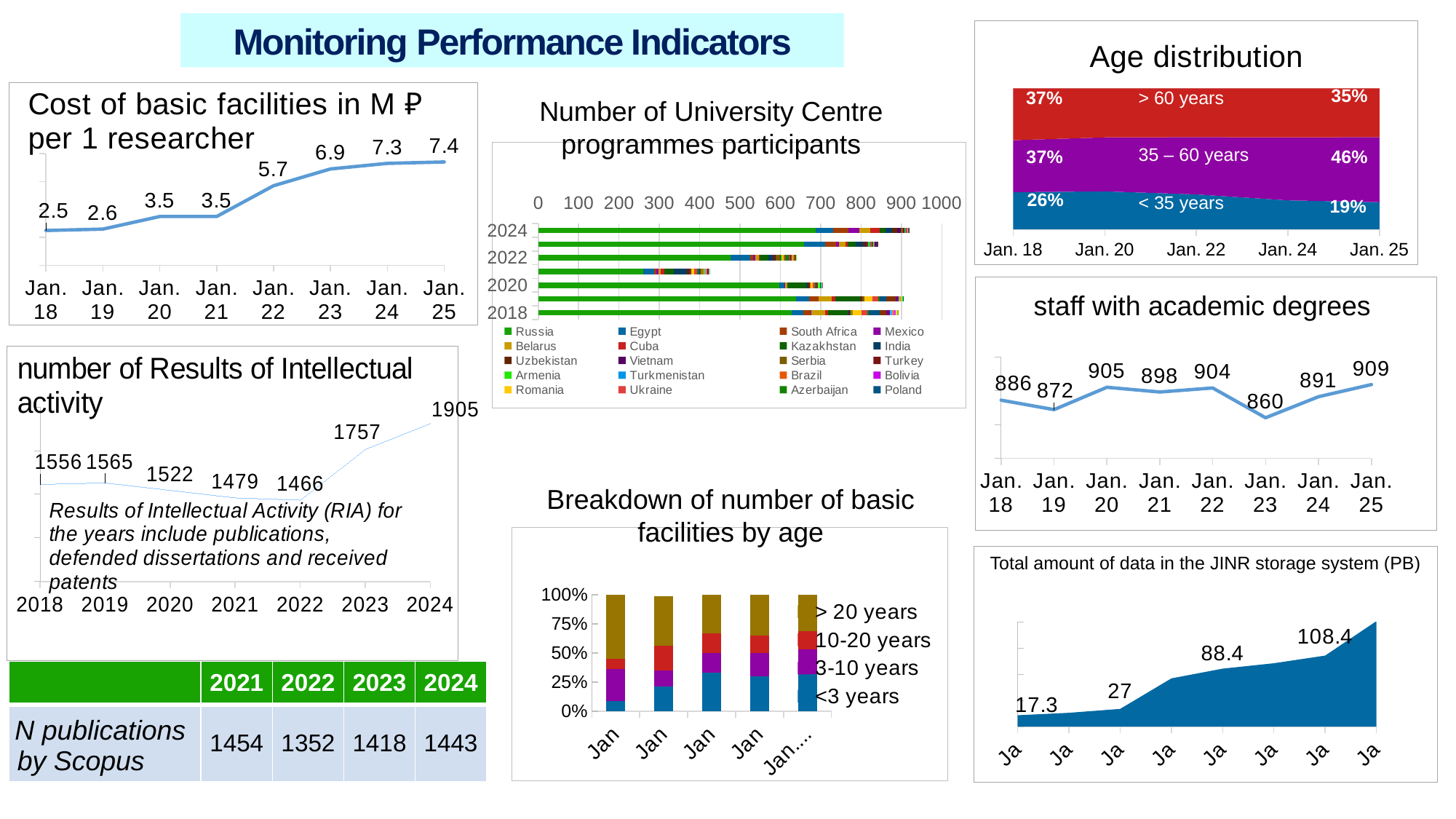
In the chart 'Age distribution', what is the share of the '< 35 years' group at Jan. 25? 19% In the chart 'Total amount of data in the JINR storage system (PB)', what is the highest labelled value? 108.4 In the chart 'number of Results of Intellectual activity', what is the value for 2024? 1905 In the chart 'Cost of basic facilities in M ₽ per 1 researcher', what is the difference between the values for Jan. 22 and Jan. 21? 2.2 In the chart 'number of Results of Intellectual activity', which year has the lowest value? 2022 In the chart 'Cost of basic facilities in M ₽ per 1 researcher', do the values generally rise or fall from Jan. 18 to Jan. 25? rise In the chart 'staff with academic degrees', which is larger, the value for Jan. 20 or the value for Jan. 24? Jan. 20 What kind of chart is 'Number of University Centre programmes participants'? bar chart In the chart 'staff with academic degrees', what is the value for Jan. 23? 860 In the chart 'Cost of basic facilities in M ₽ per 1 researcher', what is the value for Jan. 25? 7.4 In the chart 'staff with academic degrees', which date has the highest value? Jan. 25 In the chart 'number of Results of Intellectual activity', how many years are plotted? 7